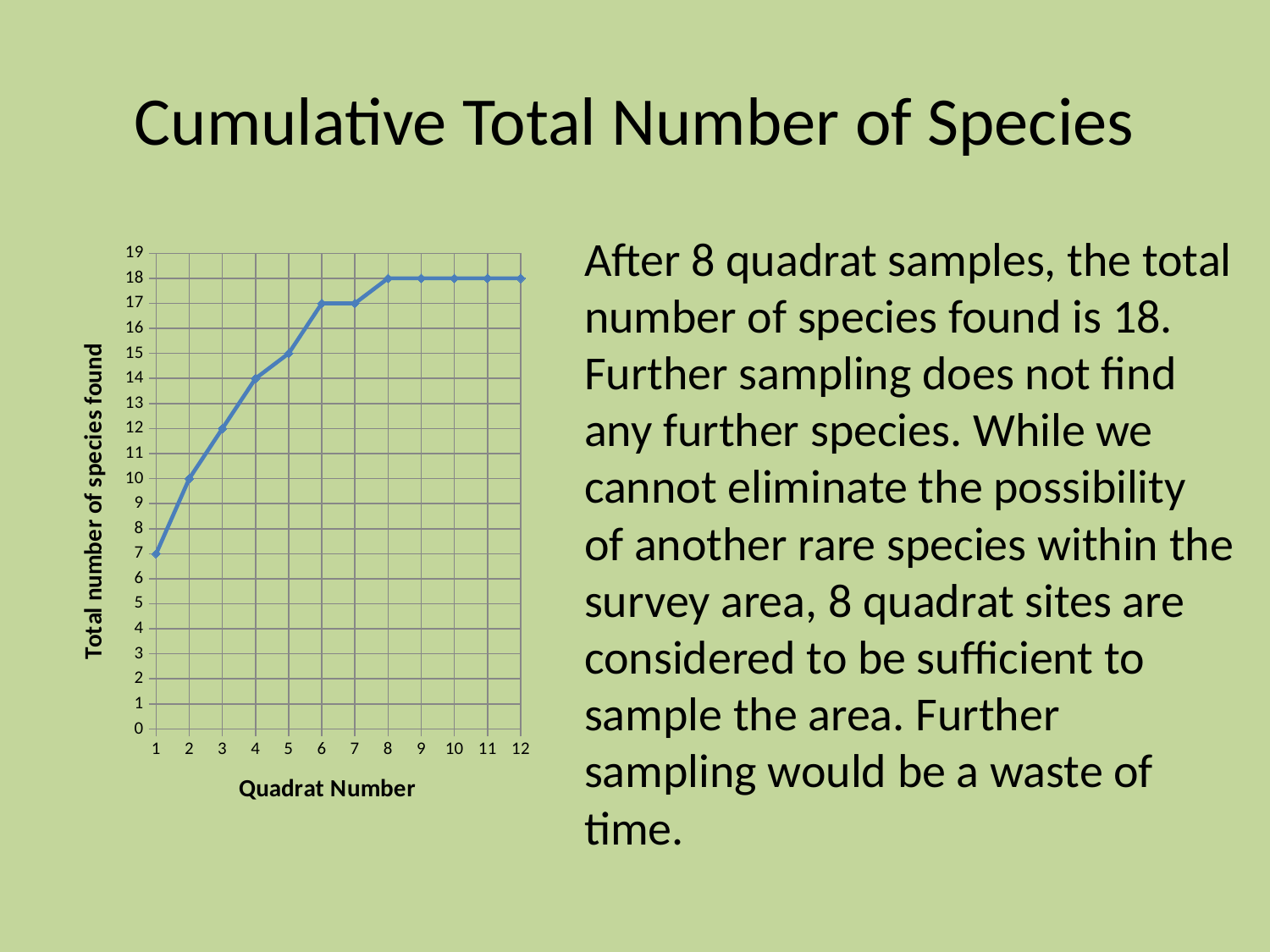
Do the values generally rise or fall as the quadrat number increases from 1 to 8? rise What kind of chart is shown on the slide? line chart What is the total number of species found at quadrat number 4? 14 Which quadrat number has the lowest total number of species found? 1 How many quadrat numbers are plotted on the x axis? 12 What is the total number of species found at quadrat number 8? 18 What is the total number of species found at quadrat number 1? 7 What is the total number of species found at quadrat number 12? 18 What is the label of the x axis? Quadrat Number What is the label of the y axis? Total number of species found Which has a higher total number of species found, quadrat 2 or quadrat 5? quadrat 5 What is the difference in total number of species found between quadrat 1 and quadrat 8? 11